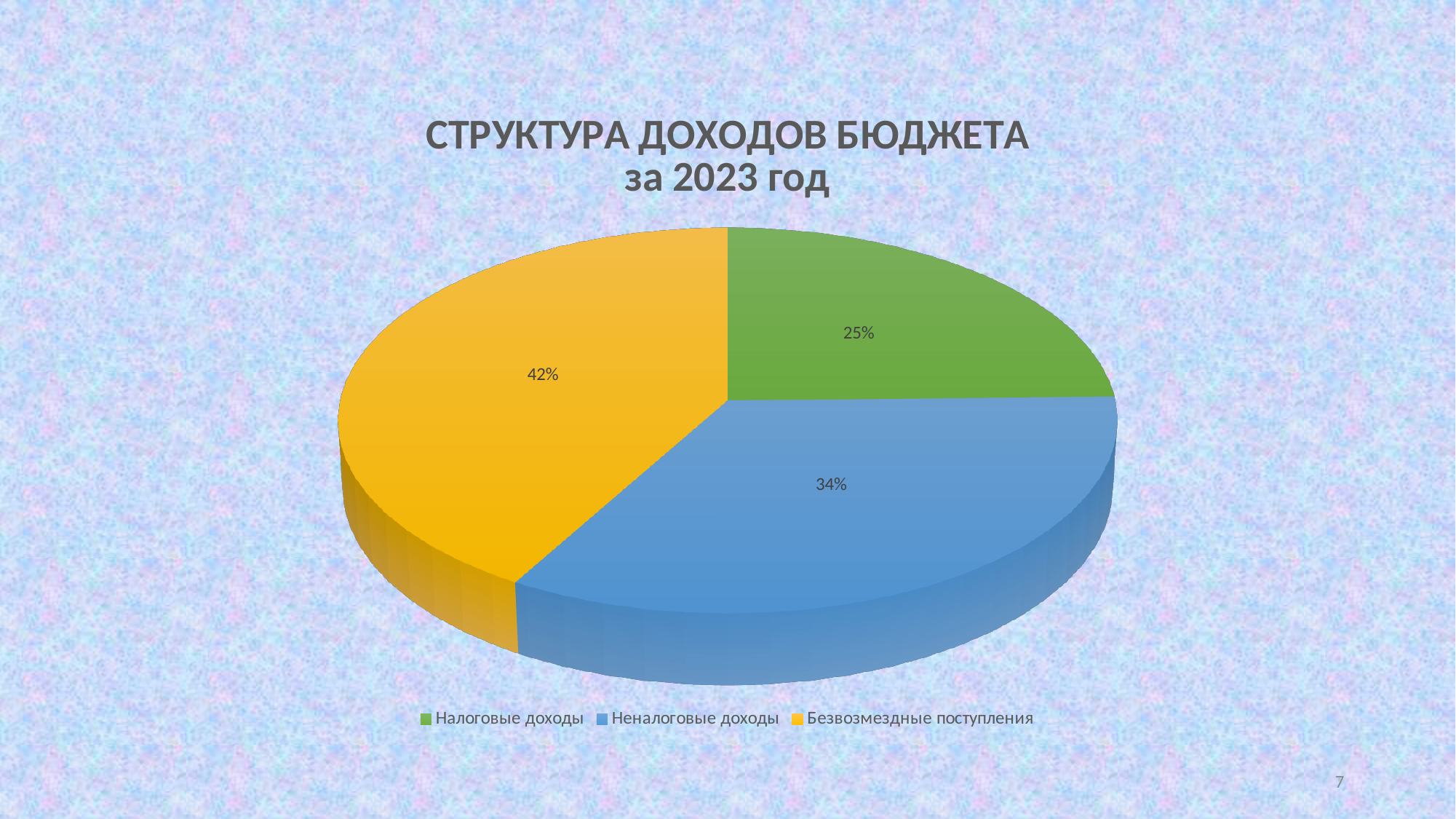
What is the difference in percentage points between Неналоговые доходы and Налоговые доходы? 9 What is the difference in percentage points between Безвозмездные поступления and Налоговые доходы? 17 Which is larger: the share for Неналоговые доходы or the share for Налоговые доходы? Неналоговые доходы Which category has the smallest slice of the pie? Налоговые доходы Which category has the largest slice of the pie? Безвозмездные поступления What share of the pie does Безвозмездные поступления have? 42% What colour is the slice for Безвозмездные поступления? Yellow What share of the pie does Неналоговые доходы have? 34% What share of the pie does Налоговые доходы have? 25% What is the title of the chart? СТРУКТУРА ДОХОДОВ БЮДЖЕТА за 2023 год What kind of chart is shown on the slide? Pie chart How many categories does the pie chart show? 3